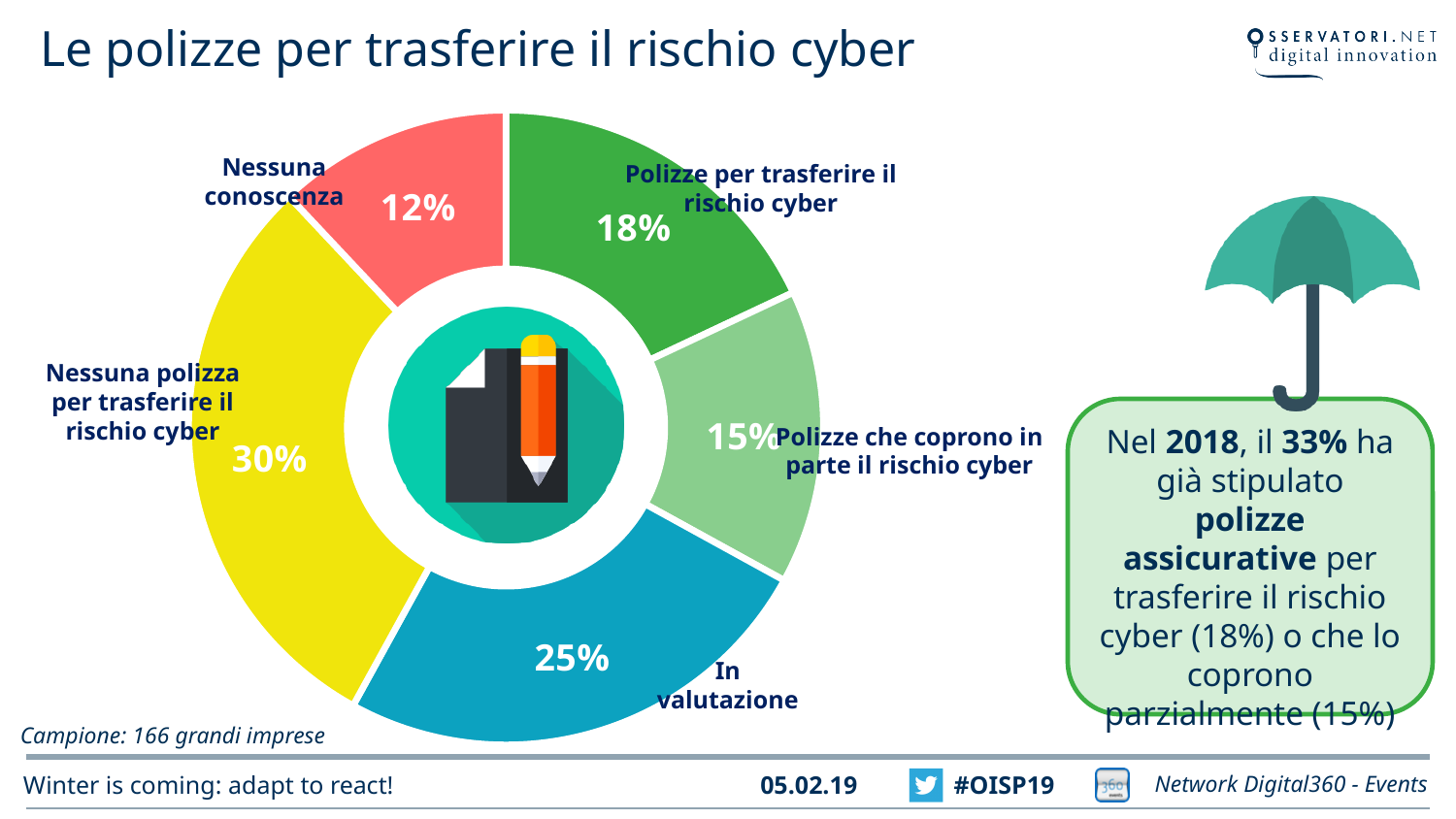
Which is larger: the share for "Polizze per trasferire il rischio cyber" or the share for "Polizze che coprono in parte il rischio cyber"? Polizze per trasferire il rischio cyber What is the combined share of "Polizze per trasferire il rischio cyber" and "Polizze che coprono in parte il rischio cyber"? 33% Which slice of the chart is the smallest? Nessuna conoscenza What is the difference in percentage points between "Nessuna polizza per trasferire il rischio cyber" and "In valutazione"? 5 What percentage is shown for "In valutazione"? 25% What percentage is shown for "Polizze che coprono in parte il rischio cyber"? 15% How many slices does the chart have? 5 What percentage of the donut chart is labelled "Polizze per trasferire il rischio cyber"? 18% Which slice of the chart is the largest? Nessuna polizza per trasferire il rischio cyber What colour is the slice for "Nessuna polizza per trasferire il rischio cyber"? Yellow What percentage is shown for "Nessuna conoscenza"? 12% What kind of chart is shown on the slide? Donut (pie) chart